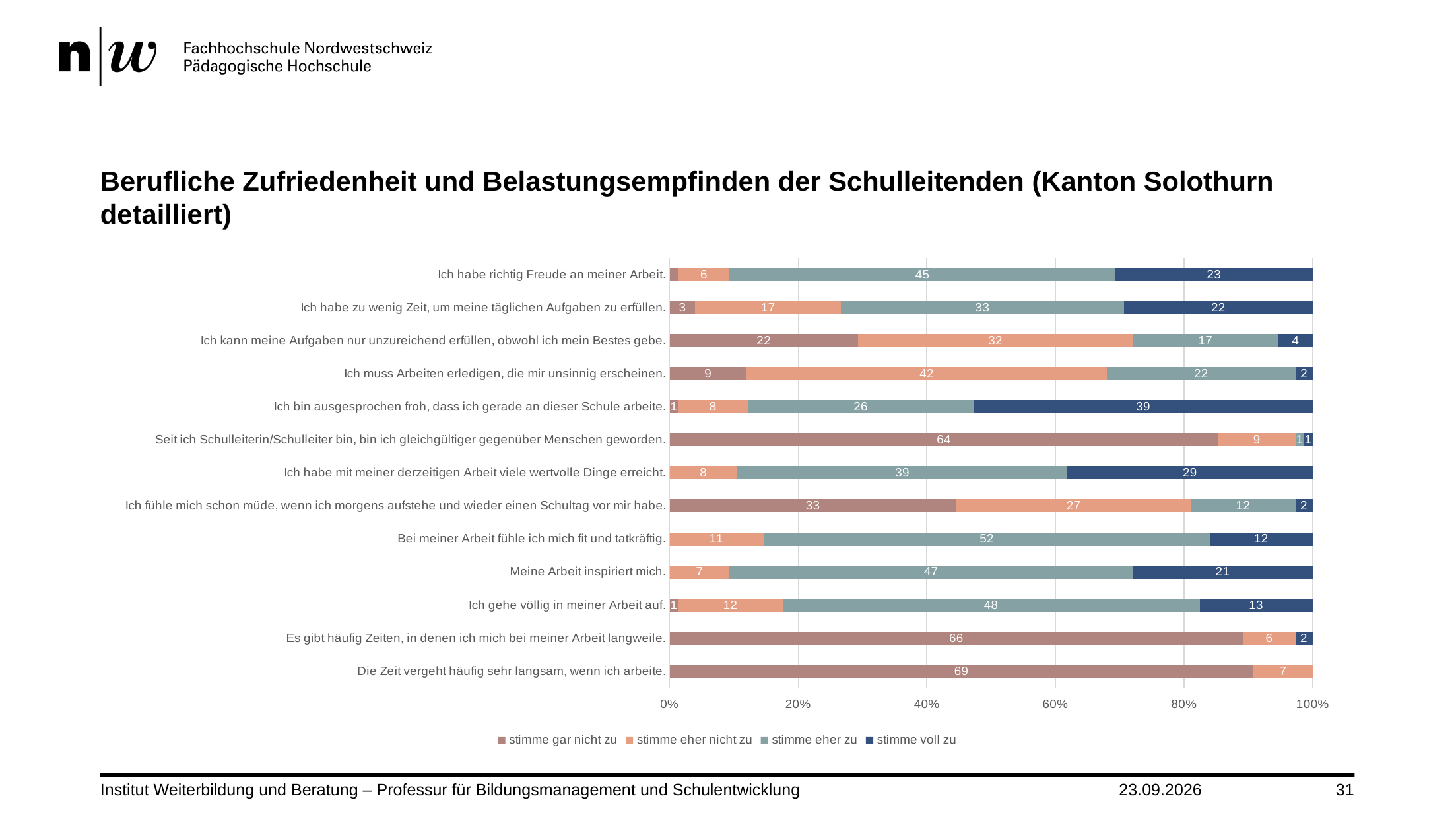
Which statement has the highest value for "stimme gar nicht zu"? Die Zeit vergeht häufig sehr langsam, wenn ich arbeite. How many series does the legend list? 4 Which statement has the larger "stimme eher nicht zu" value: "Ich muss Arbeiten erledigen, die mir unsinnig erscheinen." or "Ich kann meine Aufgaben nur unzureichend erfüllen, obwohl ich mein Bestes gebe."? Ich muss Arbeiten erledigen, die mir unsinnig erscheinen. Which statement has the highest value for "stimme voll zu"? Ich bin ausgesprochen froh, dass ich gerade an dieser Schule arbeite. How many statements are shown in the chart? 13 What kind of chart is shown on the slide? Stacked bar chart Which colour represents "stimme voll zu" in the legend? Dark blue What is the value for "stimme voll zu" for the statement "Ich bin ausgesprochen froh, dass ich gerade an dieser Schule arbeite."? 39 What is the value for "stimme eher nicht zu" for the statement "Ich habe zu wenig Zeit, um meine täglichen Aufgaben zu erfüllen."? 17 What is the value for "stimme gar nicht zu" for the statement "Die Zeit vergeht häufig sehr langsam, wenn ich arbeite."? 69 What is the value for "stimme eher zu" for the statement "Ich habe richtig Freude an meiner Arbeit."? 45 For the statement "Bei meiner Arbeit fühle ich mich fit und tatkräftig.", what is the difference between the "stimme eher zu" value and the "stimme voll zu" value? 40